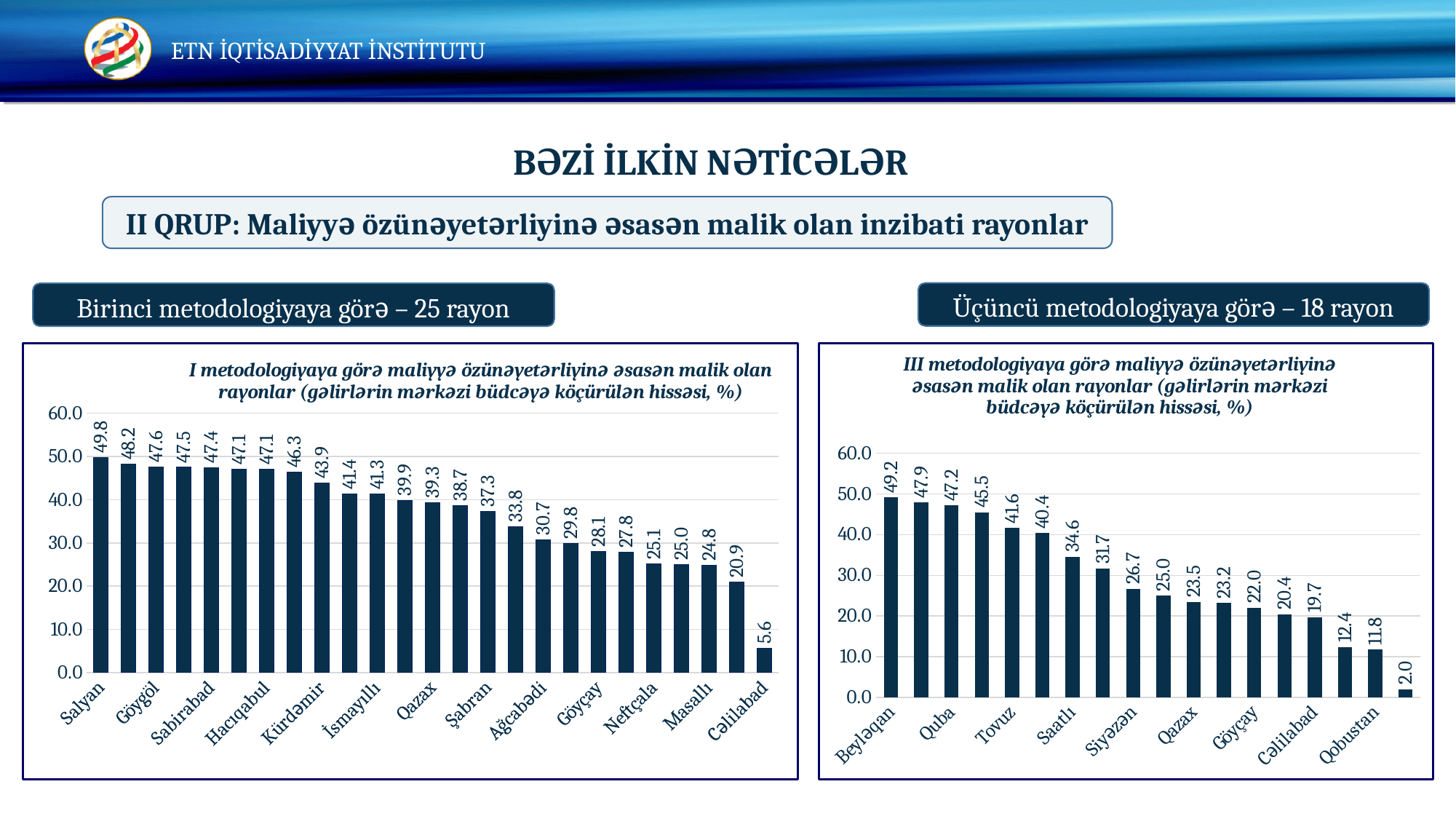
On the right chart (III metodologiyaya görə), which is larger, the value for Tovuz or the value for Saatlı? Tovuz On the right chart (III metodologiyaya görə), which labelled rayon has the lowest value? Qobustan On the left chart (I metodologiyaya görə), what is the value for Salyan? 49.8 On the left chart (I metodologiyaya görə), do the values rise or fall from left to right? Fall On the right chart (III metodologiyaya görə), what is the value for Beyləqan? 49.2 On the left chart (I metodologiyaya görə), which labelled rayon has the highest value? Salyan How many bars are plotted on the left chart (I metodologiyaya görə)? 25 What kind of chart is the right chart (III metodologiyaya görə)? Bar chart How many bars are plotted on the right chart (III metodologiyaya görə)? 18 On the right chart (III metodologiyaya görə), what is the value for Qobustan? 11.8 On the left chart (I metodologiyaya görə), what is the value for Cəlilabad? 5.6 On the left chart (I metodologiyaya görə), what is the difference between the values for Salyan and Cəlilabad? 44.2